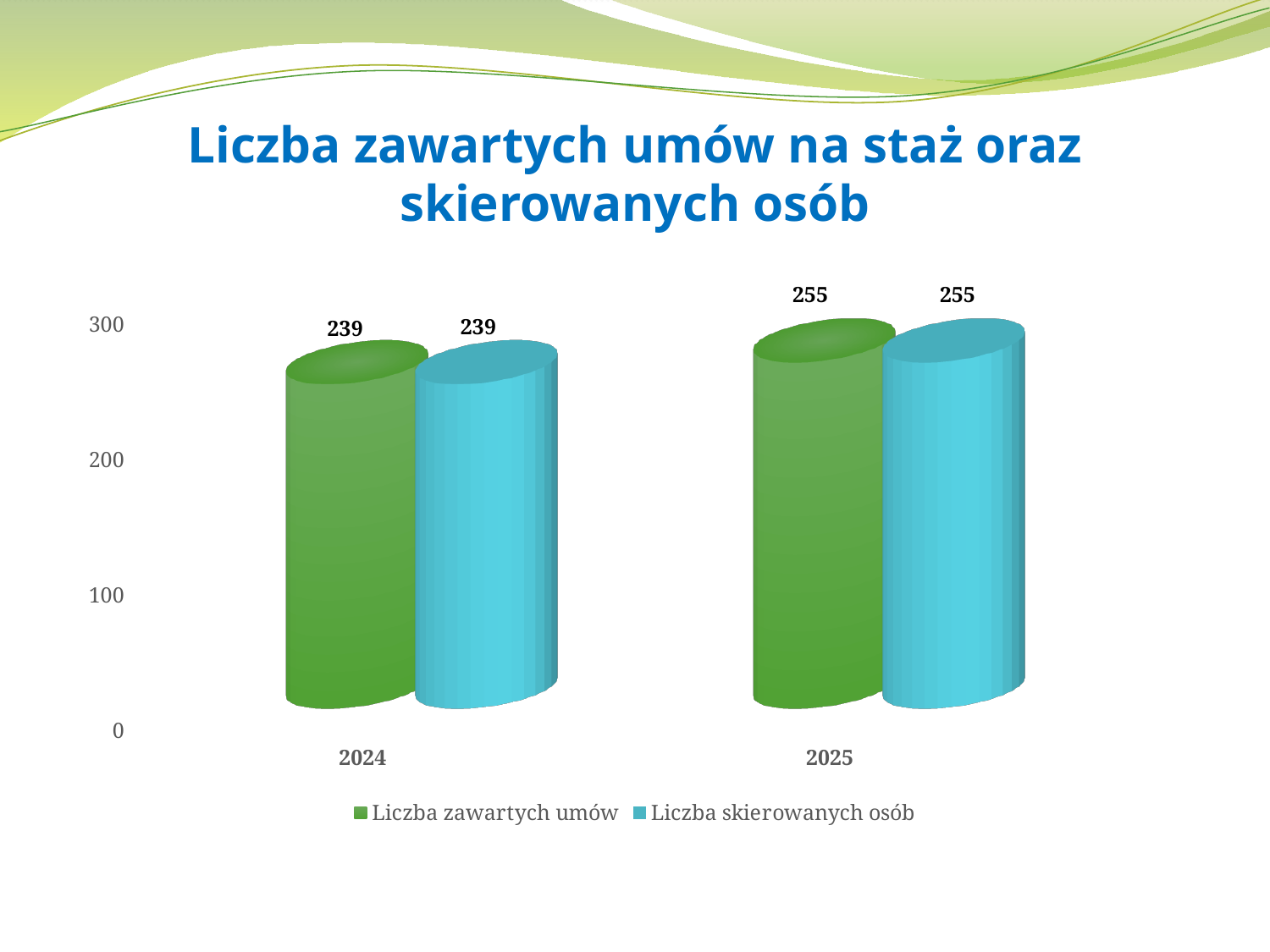
What is the difference between the Liczba zawartych umów values for 2025 and 2024? 16 What is the value of Liczba zawartych umów for 2024? 239 How many series does the legend list? 2 What is the value of Liczba zawartych umów for 2025? 255 What kind of chart is shown on the slide? bar chart Which year has the lower value for Liczba skierowanych osób? 2024 Is the value for Liczba skierowanych osób in 2024 greater or less than 200? greater How many years are shown on the x axis? 2 What is the value of Liczba skierowanych osób for 2025? 255 What is the value of Liczba skierowanych osób for 2024? 239 Do the values for Liczba zawartych umów rise or fall from 2024 to 2025? rise Which year has the higher value for Liczba zawartych umów? 2025